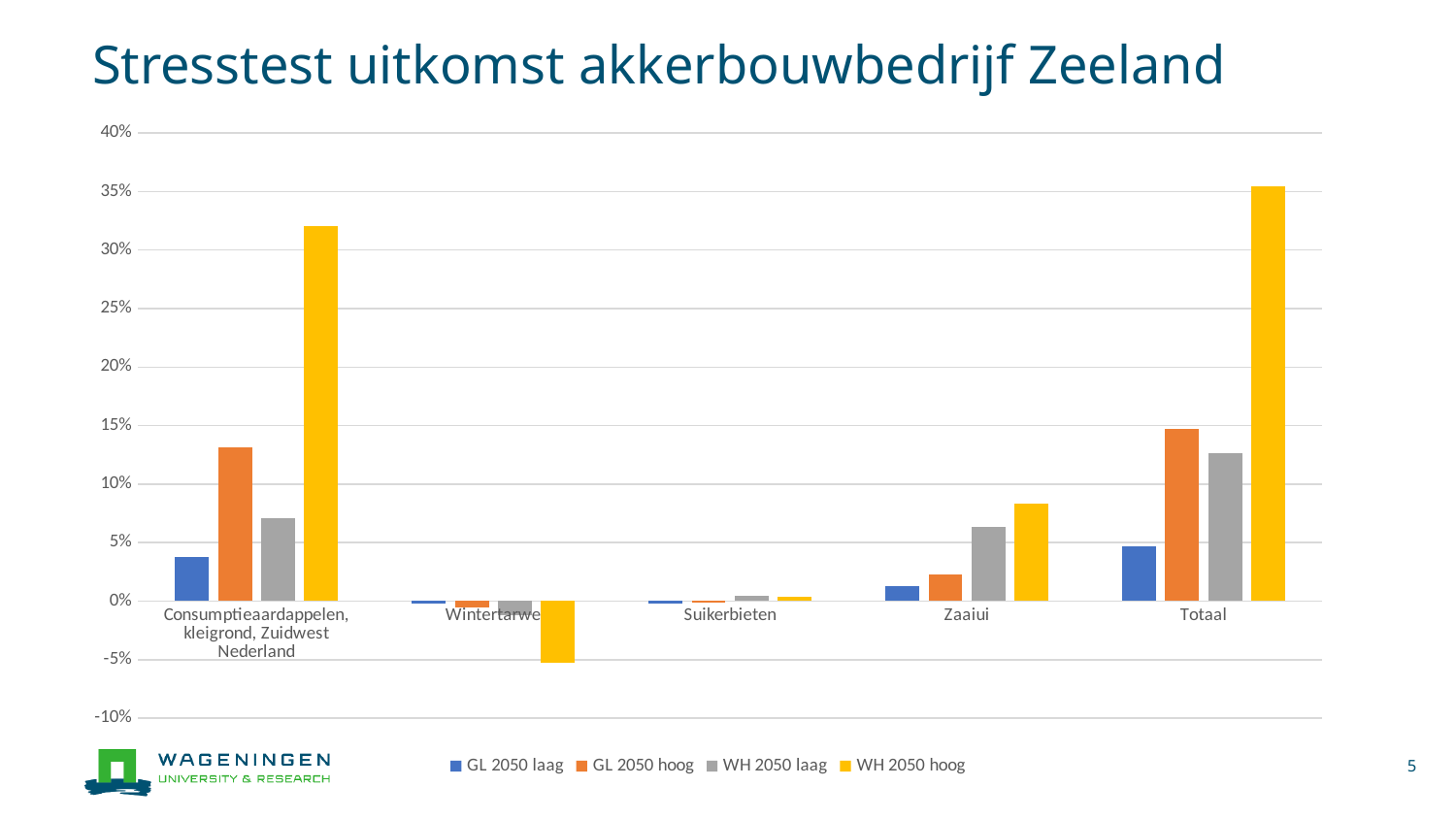
For Totaal, which is larger: GL 2050 hoog or WH 2050 laag? GL 2050 hoog What kind of chart is shown on the slide? bar chart Which category has the lowest value for WH 2050 hoog? Wintertarwe Is the WH 2050 hoog value for Totaal greater or less than 30%? greater How many series does the legend list? 4 For Zaaiui, which is larger: GL 2050 hoog or WH 2050 hoog? WH 2050 hoog Is the WH 2050 hoog value for Consumptieaardappelen, kleigrond, Zuidwest Nederland greater or less than 25%? greater What is the title of the slide? Stresstest uitkomst akkerbouwbedrijf Zeeland What colour represents the WH 2050 hoog series? yellow Which category has the highest value for WH 2050 hoog? Totaal Is the WH 2050 hoog value for Wintertarwe greater or less than 0%? less How many categories are shown on the x axis? 5